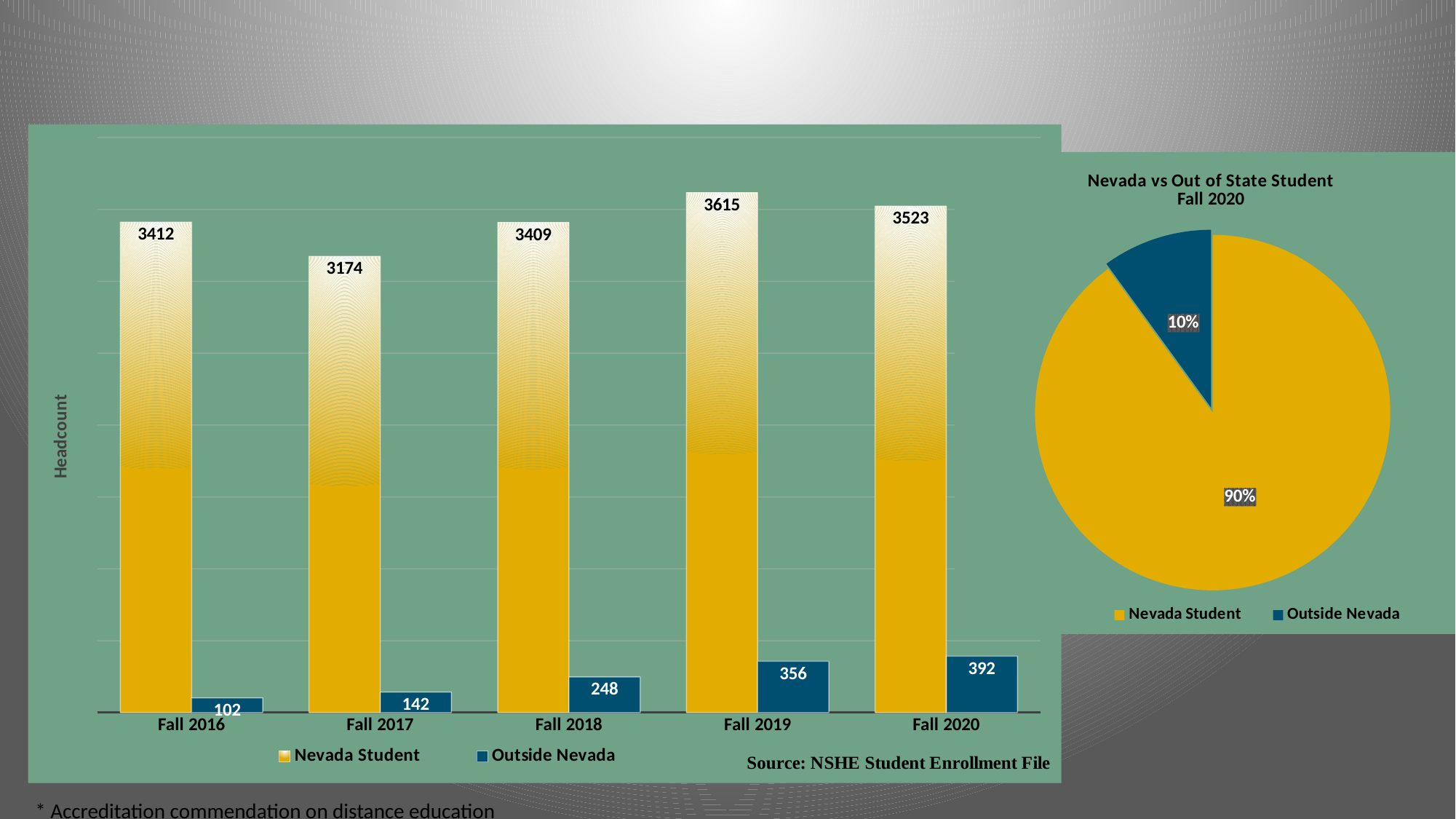
In the bar chart on the left, how many terms are shown on the x axis? 5 In the bar chart on the left, which is larger: the Nevada Student headcount in Fall 2016 or in Fall 2018? Fall 2016 In the pie chart titled 'Nevada vs Out of State Student Fall 2020', what share is Outside Nevada? 10% In the bar chart on the left, how many series does the legend list? 2 In the bar chart on the left, which term has the lowest Outside Nevada headcount? Fall 2016 In the bar chart on the left, does the Outside Nevada headcount rise or fall from Fall 2016 to Fall 2020? rise In the bar chart on the left, what is the Outside Nevada headcount for Fall 2016? 102 In the bar chart on the left, what is the label on the vertical axis? Headcount In the bar chart on the left, what is the difference between the Outside Nevada headcount in Fall 2020 and in Fall 2019? 36 What kind of chart is the chart on the right of the slide? pie chart In the bar chart on the left, which term has the highest Nevada Student headcount? Fall 2019 In the bar chart on the left, what is the Nevada Student headcount for Fall 2019? 3615